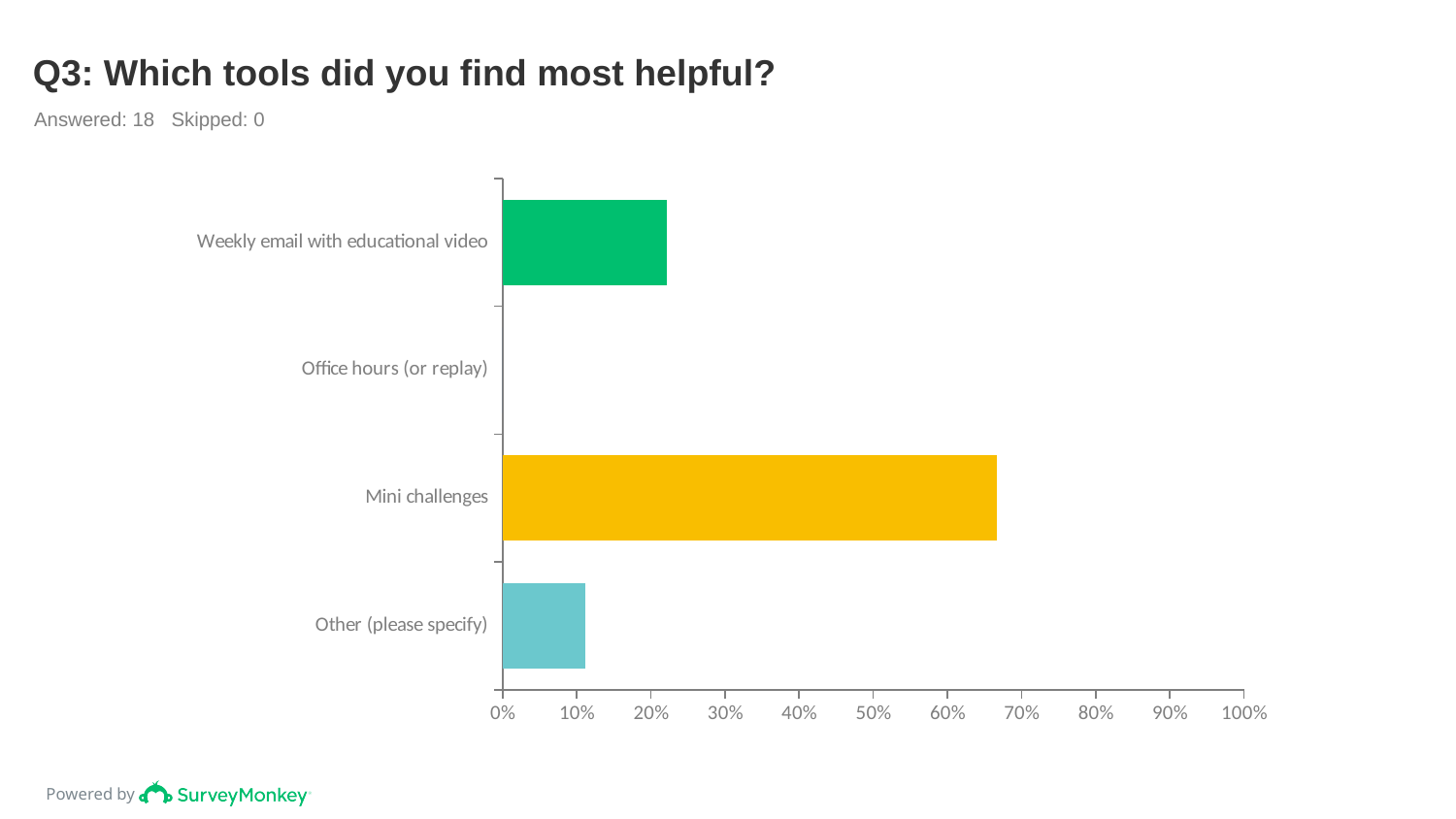
Is the value for Weekly email with educational video greater or less than 30%? less Which is larger, the value for Mini challenges or the value for Weekly email with educational video? Mini challenges Which category has the lowest value? Office hours (or replay) Which category has the highest value? Mini challenges Is the value for Weekly email with educational video greater or less than 20%? greater Which is larger, the value for Weekly email with educational video or the value for Other (please specify)? Weekly email with educational video How many categories are shown in the chart? 4 What is the title of the chart? Q3: Which tools did you find most helpful? Is the value for Other (please specify) greater or less than 20%? less What kind of chart is shown on the slide? bar chart How many respondents answered the question according to the slide? 18